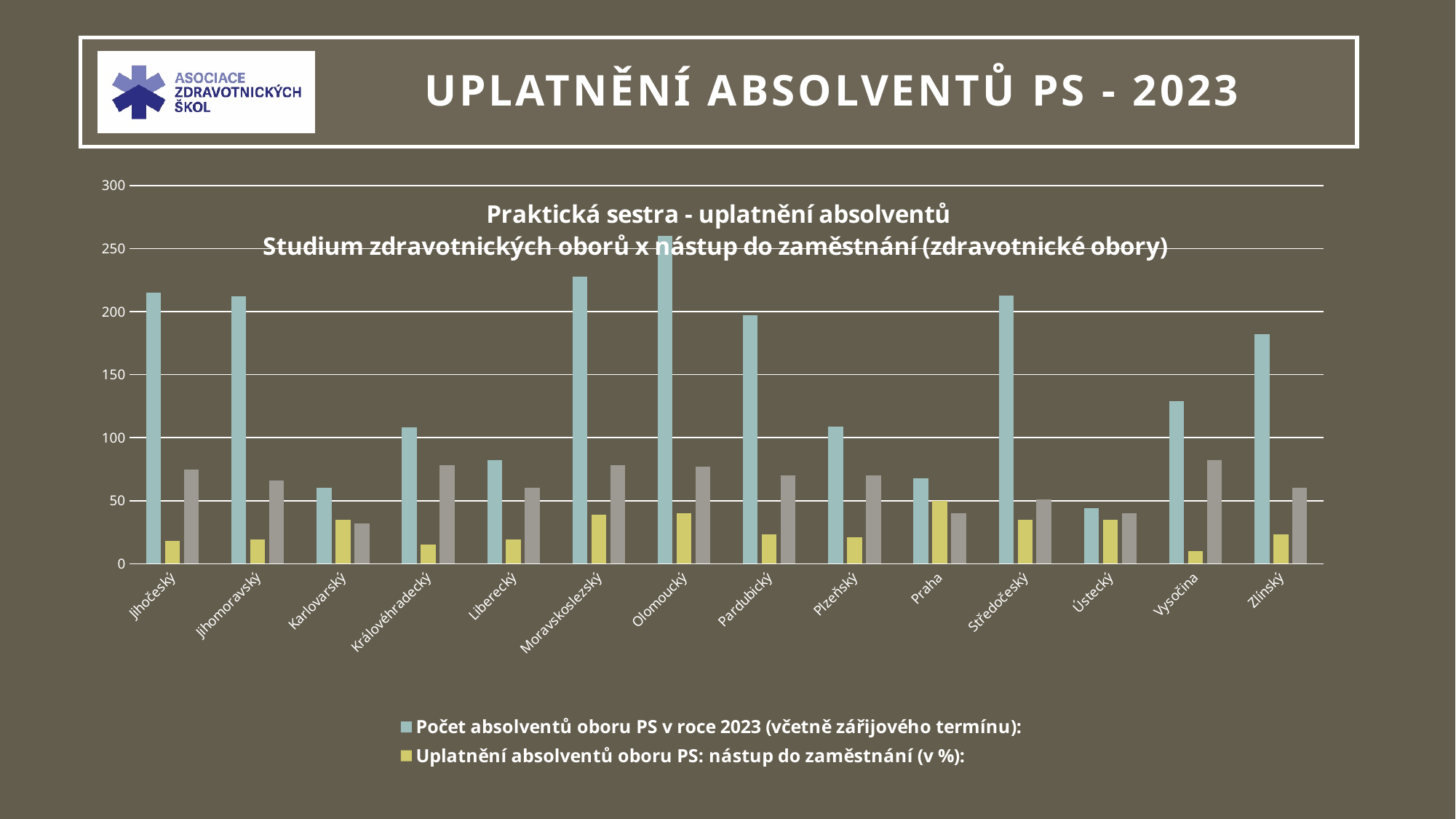
What is the title of the chart? Praktická sestra - uplatnění absolventů Studium zdravotnických oborů x nástup do zaměstnání (zdravotnické obory) How many series does the chart's legend list? 2 Which region has a larger value for 'Počet absolventů oboru PS v roce 2023': Zlínský or Vysočina? Zlínský Is the value for 'Počet absolventů oboru PS v roce 2023' in Olomoucký greater or less than 250? greater Which region has the highest value for 'Počet absolventů oboru PS v roce 2023'? Olomoucký What kind of chart is shown on the slide? bar chart How many regions (categories) are shown on the x axis of the chart? 14 Is the value for 'Počet absolventů oboru PS v roce 2023' in Ústecký greater or less than 50? less Is the value for 'Počet absolventů oboru PS v roce 2023' in Pardubický greater or less than 150? greater Which region has the highest value for 'Uplatnění absolventů oboru PS: nástup do zaměstnání (v %)'? Praha Which region has the lowest value for 'Uplatnění absolventů oboru PS: nástup do zaměstnání (v %)'? Vysočina Which region has the lowest value for 'Počet absolventů oboru PS v roce 2023'? Ústecký